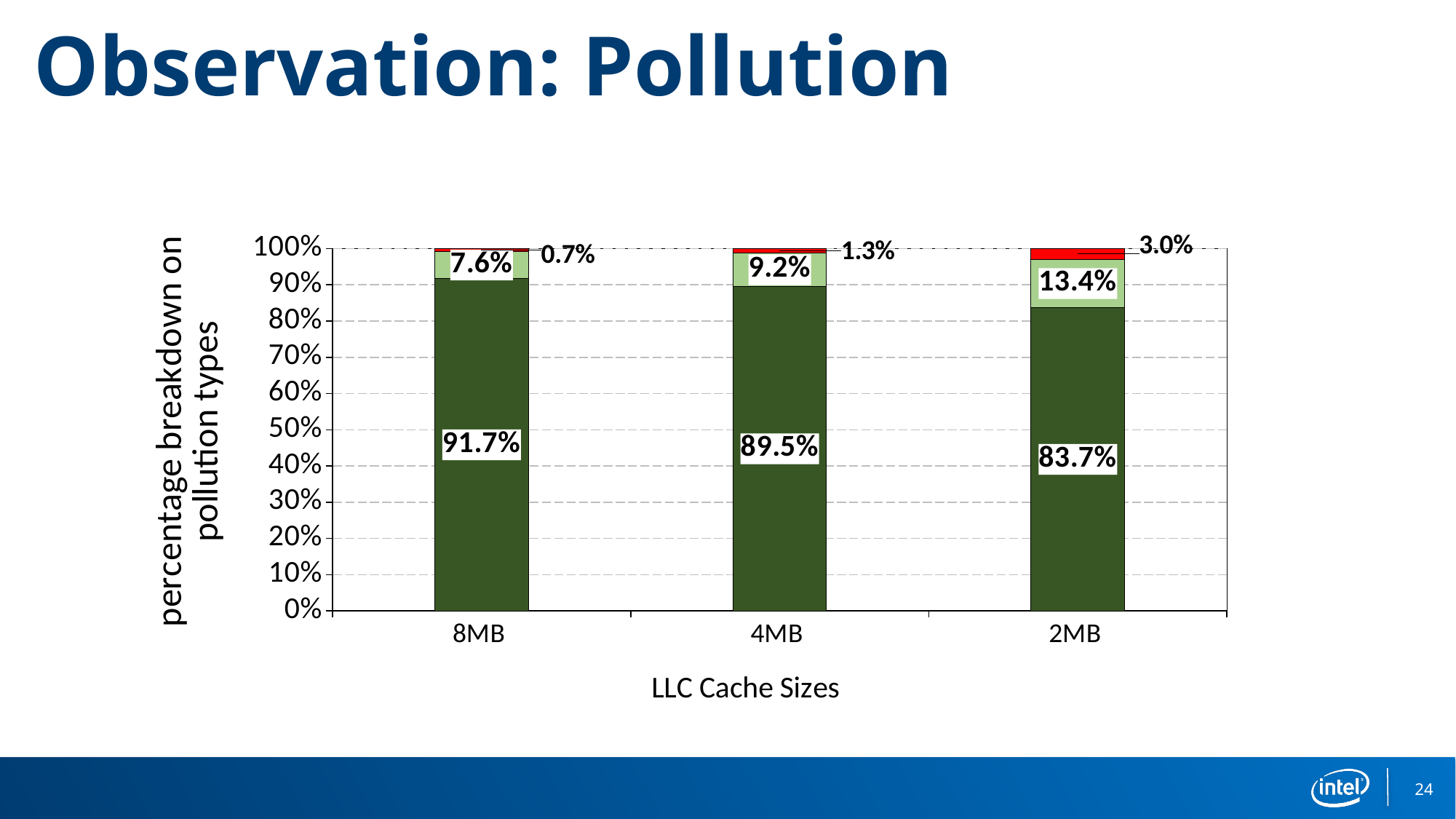
Which LLC cache size has the lowest red segment value? 8MB What kind of chart is shown on the slide? Stacked bar chart What is the value of the dark green segment for 8MB? 91.7% What is the difference between the dark green segment values for 8MB and 2MB? 8.0% What is the value of the light green segment for 2MB? 13.4% What is the label of the x axis? LLC Cache Sizes What is the value of the dark green segment for 4MB? 89.5% Which LLC cache size has the highest dark green segment value? 8MB How many LLC cache sizes are shown on the x axis? 3 What is the value of the red segment for 4MB? 1.3% Does the dark green segment value rise or fall from 8MB to 2MB along the x axis? Fall Which is larger: the light green segment for 4MB or the light green segment for 2MB? 2MB